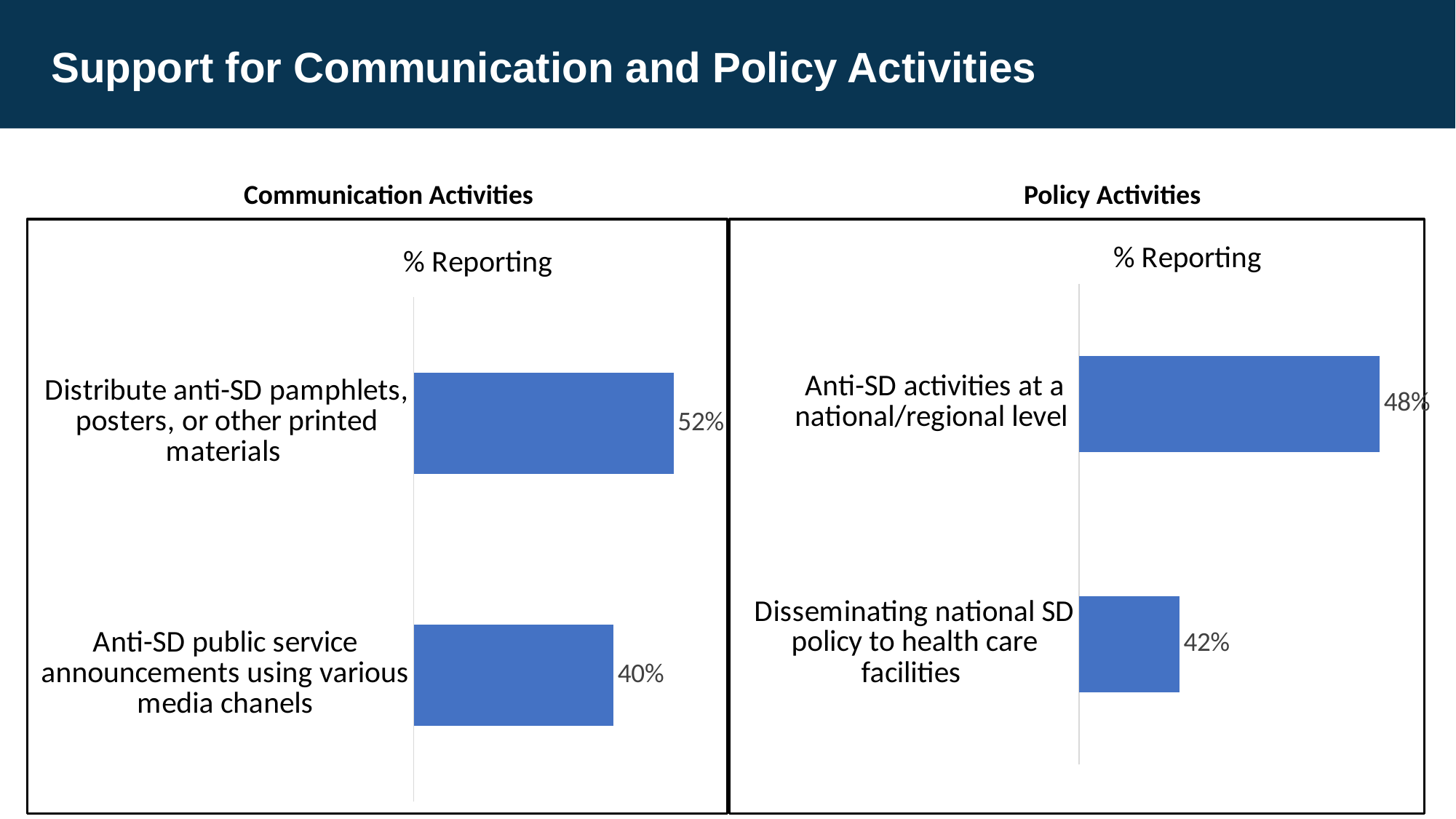
Which is larger: the value for 'Distribute anti-SD pamphlets, posters, or other printed materials' in the Communication Activities chart or the value for 'Anti-SD activities at a national/regional level' in the Policy Activities chart? Distribute anti-SD pamphlets, posters, or other printed materials In the Policy Activities chart, what is the difference between the two bars' values? 6% What type of chart is the Communication Activities chart? Bar chart In the Communication Activities chart, what is the difference between the two bars' values? 12% In the Policy Activities chart, what is the value for 'Disseminating national SD policy to health care facilities'? 42% How many categories are shown in the Policy Activities chart? 2 In the Policy Activities chart, which category has the lowest value? Disseminating national SD policy to health care facilities In the Communication Activities chart, what is the value for 'Distribute anti-SD pamphlets, posters, or other printed materials'? 52% In the Communication Activities chart, which category has the highest value? Distribute anti-SD pamphlets, posters, or other printed materials What is the title shown inside the Policy Activities chart? % Reporting In the Communication Activities chart, what is the value for 'Anti-SD public service announcements using various media chanels'? 40% In the Policy Activities chart, what is the value for 'Anti-SD activities at a national/regional level'? 48%